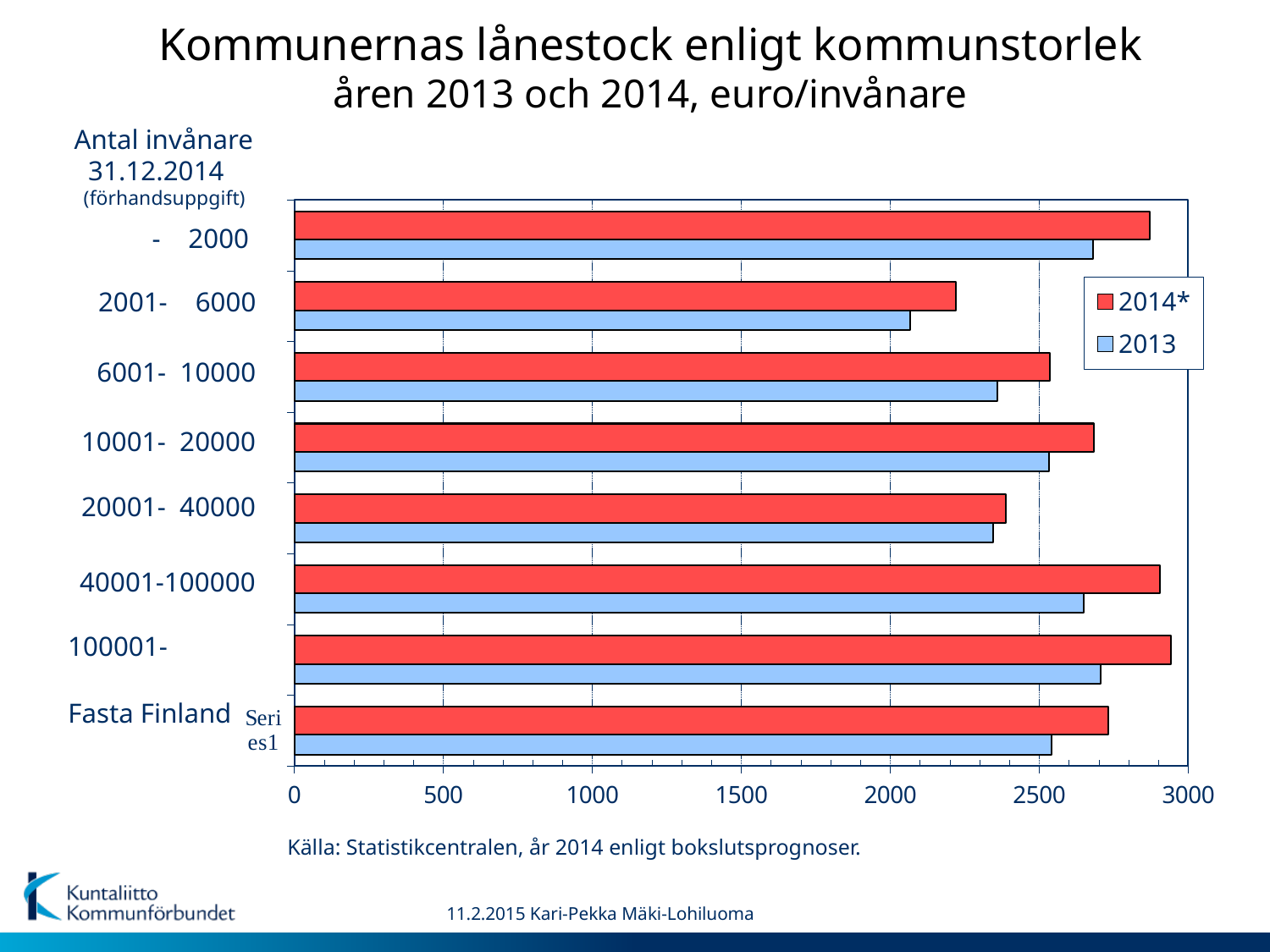
How many population-size categories are plotted on the chart? 8 For 2014*, which is larger: the value for - 2000 or the value for 2001- 6000? - 2000 Which category has the lowest value for 2013? 2001- 6000 Which category has the lowest value for 2014*? 2001- 6000 Is the 2014* value for the - 2000 category greater or less than 2500? greater What kind of chart is shown on the slide? bar chart Is the 2014* value for the 2001- 6000 category greater or less than 2000? greater For the 6001- 10000 category, which is larger: the 2014* value or the 2013 value? 2014* Is the 2013 value for the 100001- category greater or less than 2500? greater How many series does the legend list? 2 Which series is shown in red according to the legend? 2014*